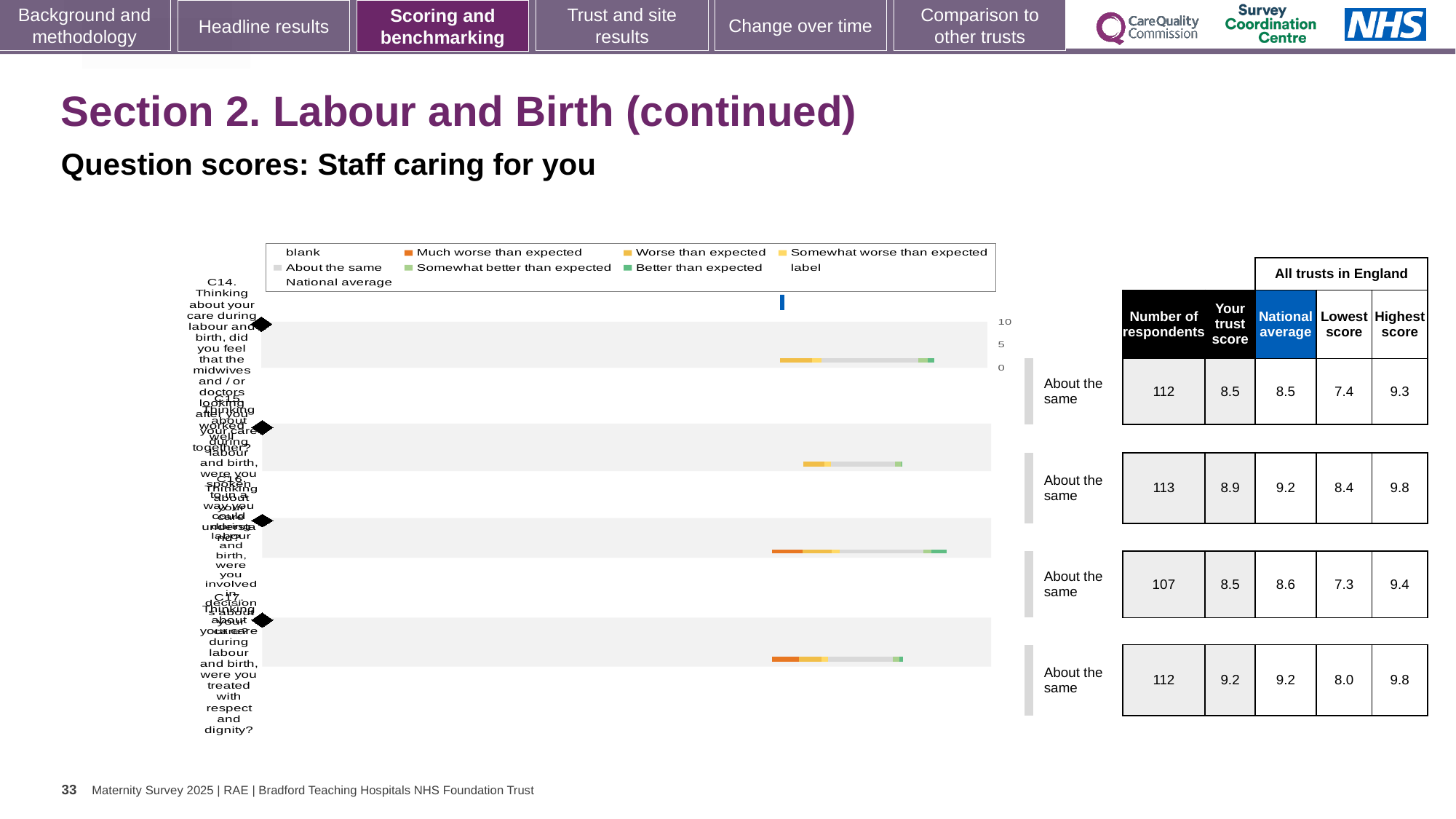
In the second row, which is larger: the trust score or the national average? the national average (9.2) What kind of chart is shown on the slide? bar chart Which row has the highest 'Your trust score'? C17, the last row (9.2) What benchmark label is shown next to each of the four rows? About the same What is the national average for the second row of the table? 9.2 Which row has the lowest number of respondents? the third row (107) What colour represents 'Much worse than expected' in the legend? orange For C14 (the first row), what is the difference between the highest score and the lowest score across all trusts in England? 1.9 What is the number of respondents for C17 (the last row), about being treated with respect and dignity? 112 What is the 'Your trust score' for C14 (the first row), about midwives and/or doctors working well together? 8.5 How many question rows (bars) does the chart show? 4 What is the lowest score across all trusts in England for the third row of the table? 7.3